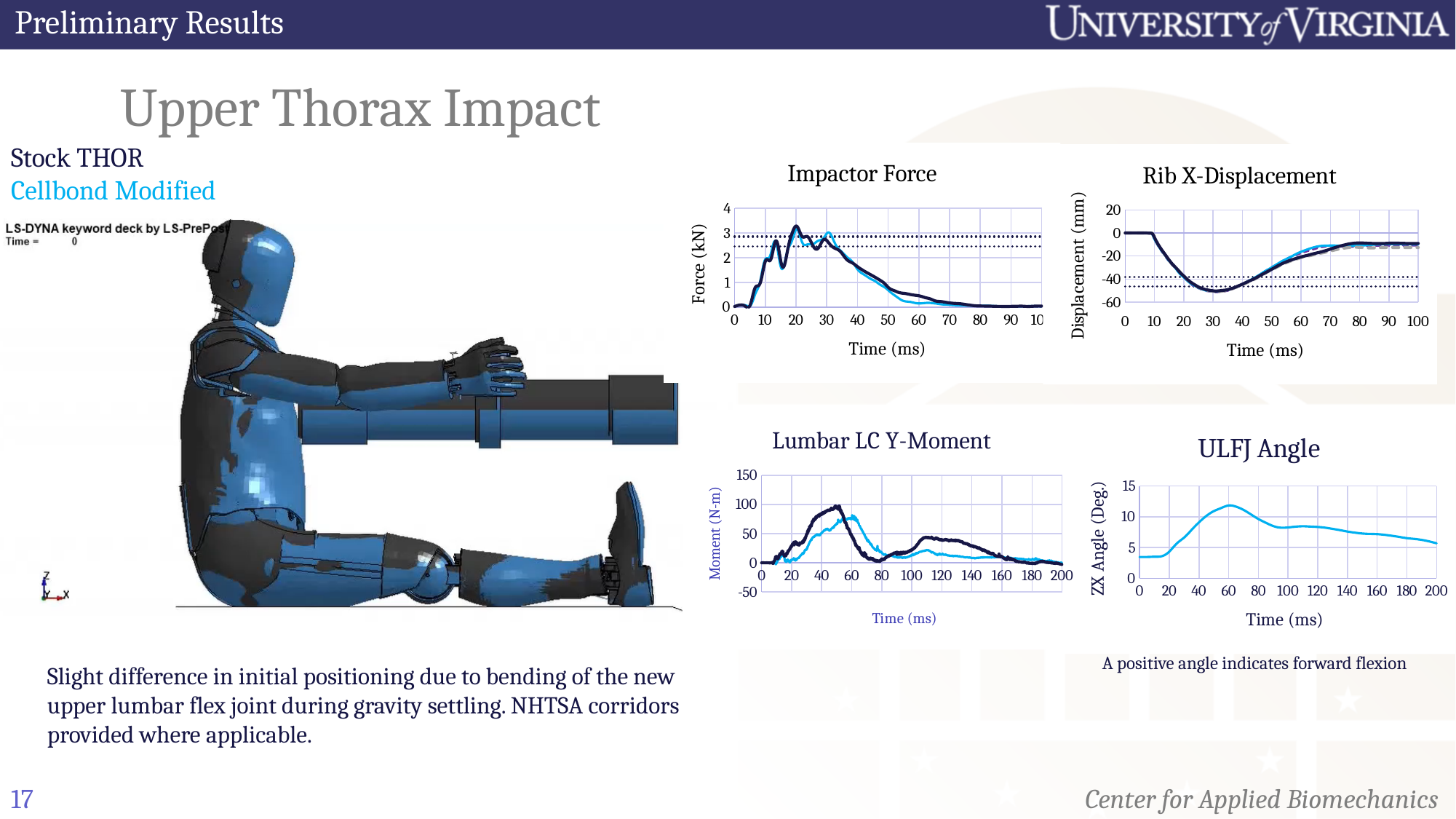
In the Impactor Force chart, is the peak force for Stock THOR greater or less than 2 kN? greater What kind of chart is the Impactor Force chart? line chart In the ULFJ Angle chart, is the angle at 0 ms greater or less than 5 degrees? less In the ULFJ Angle chart, is the peak angle greater or less than 10 degrees? greater What is the title of the chart in the bottom-left of the chart area? Lumbar LC Y-Moment In the ULFJ Angle chart, does the angle rise or fall between 0 ms and 60 ms? rise In the Lumbar LC Y-Moment chart, which series reaches the higher peak moment, Stock THOR or Cellbond Modified? Stock THOR What is the y-axis label of the Rib X-Displacement chart? Displacement (mm) How many charts are shown on the slide? 4 In the Rib X-Displacement chart, does the displacement rise or fall between 10 ms and 30 ms? fall